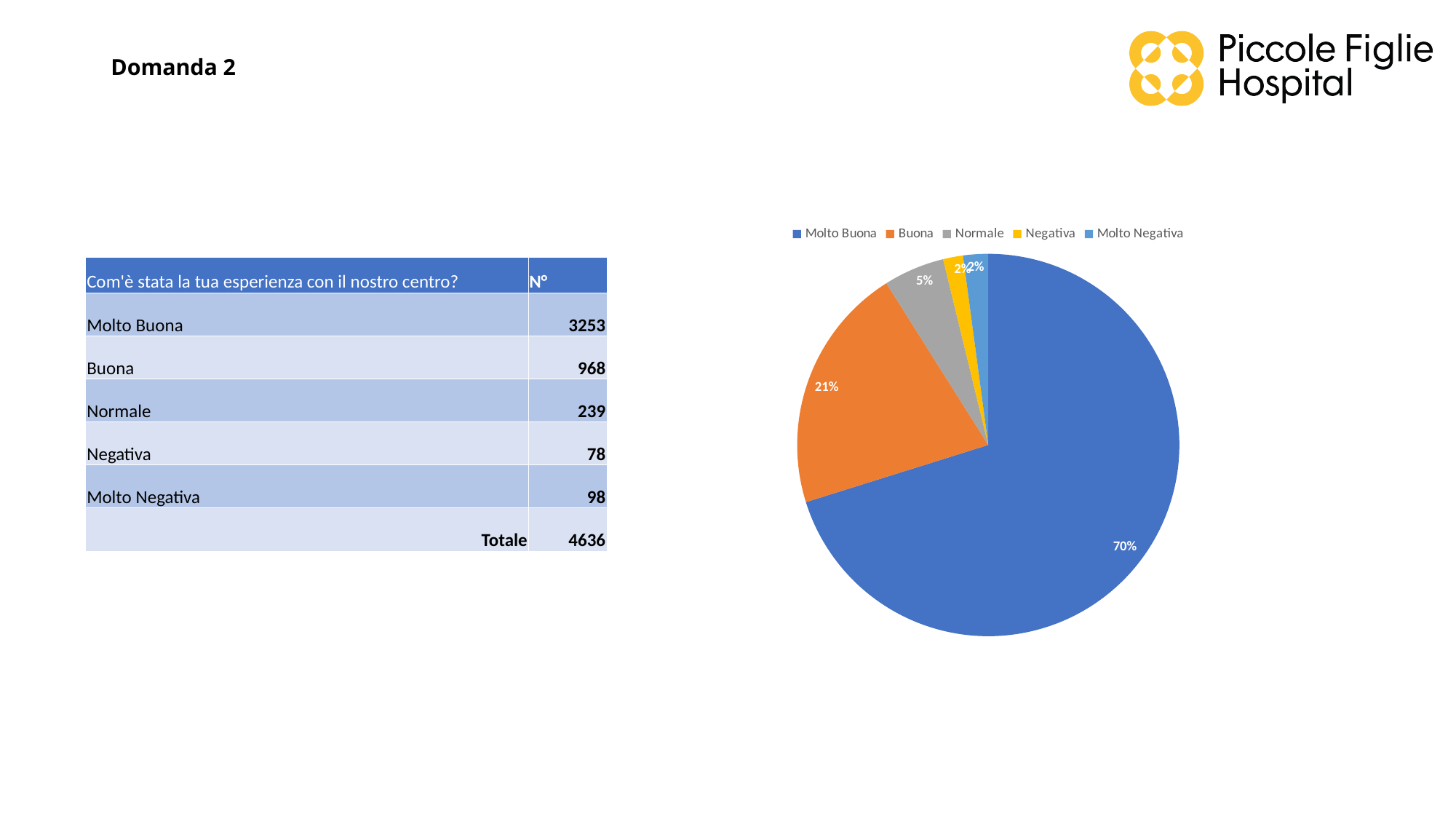
Which legend entry is shown in yellow in the pie chart? Negativa What share of the pie chart does Molto Buona represent? 70% What share of the pie chart does Normale represent? 5% Which category has the largest slice in the pie chart? Molto Buona What is the difference in percentage points between the Molto Buona and Buona slices in the pie chart? 49 What kind of chart is shown on the slide? pie chart What is the difference in percentage points between the Buona and Normale slices in the pie chart? 16 Which slice is larger in the pie chart, Buona or Normale? Buona What colour is the Buona slice in the pie chart? orange How many slices does the pie chart have? 5 How many series does the legend of the pie chart list? 5 What share of the pie chart does Buona represent? 21%